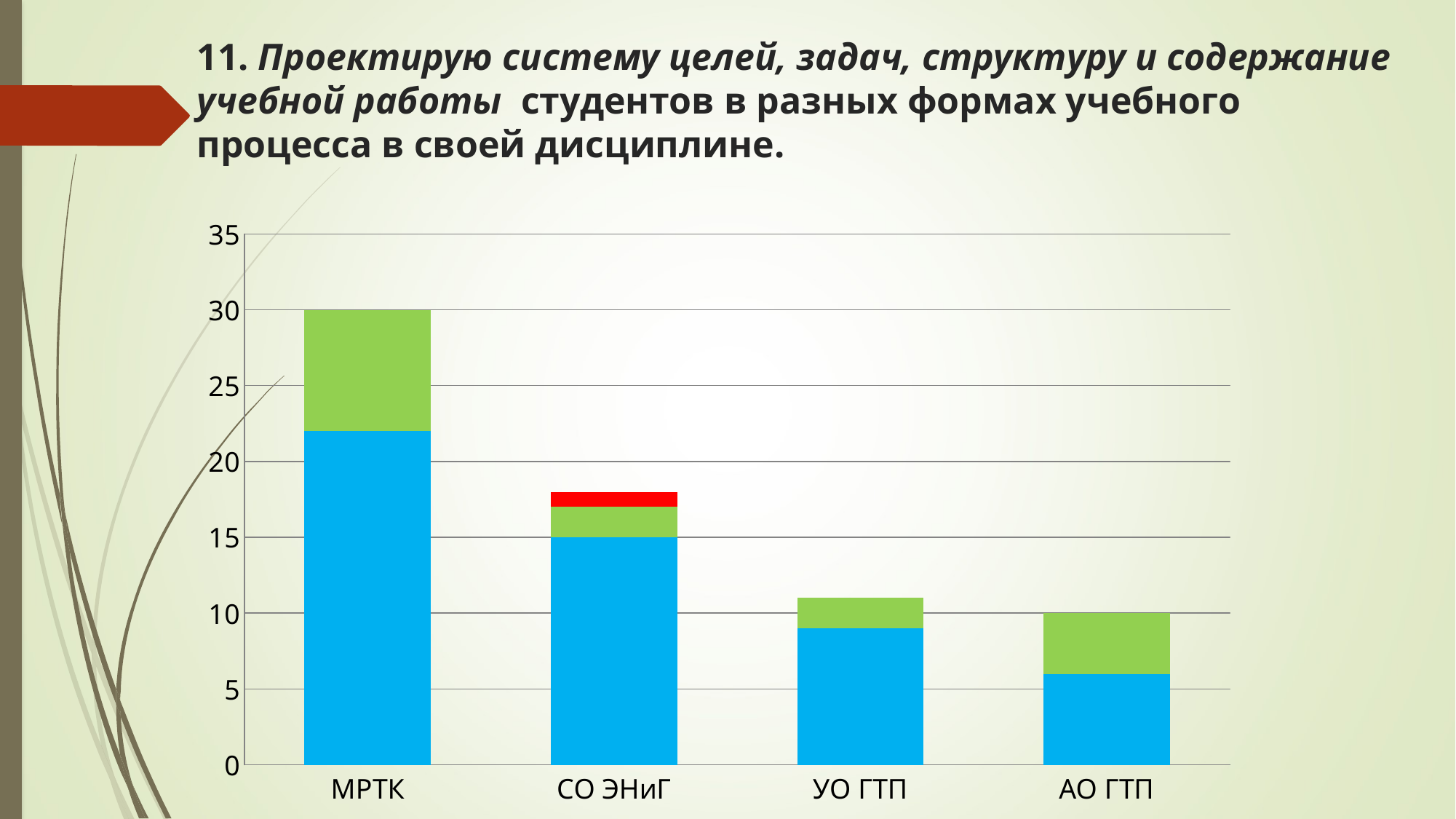
Is the total for УО ГТП greater or less than 15? less Which stacked bar is taller, МРТК or СО ЭНиГ? МРТК Do the stacked bar totals rise or fall from left to right along the x axis? fall Which category's bar includes a red segment? СО ЭНиГ Is the total for СО ЭНиГ greater or less than 20? less Is the blue segment for МРТК greater or less than 20? greater What is the total height of the stacked bar for АО ГТП? 10 What is the total height of the stacked bar for МРТК? 30 How many categories are shown on the x axis of the chart? 4 Which category has the tallest stacked bar? МРТК What kind of chart is shown on the slide? stacked bar chart Which category has the shortest stacked bar? АО ГТП